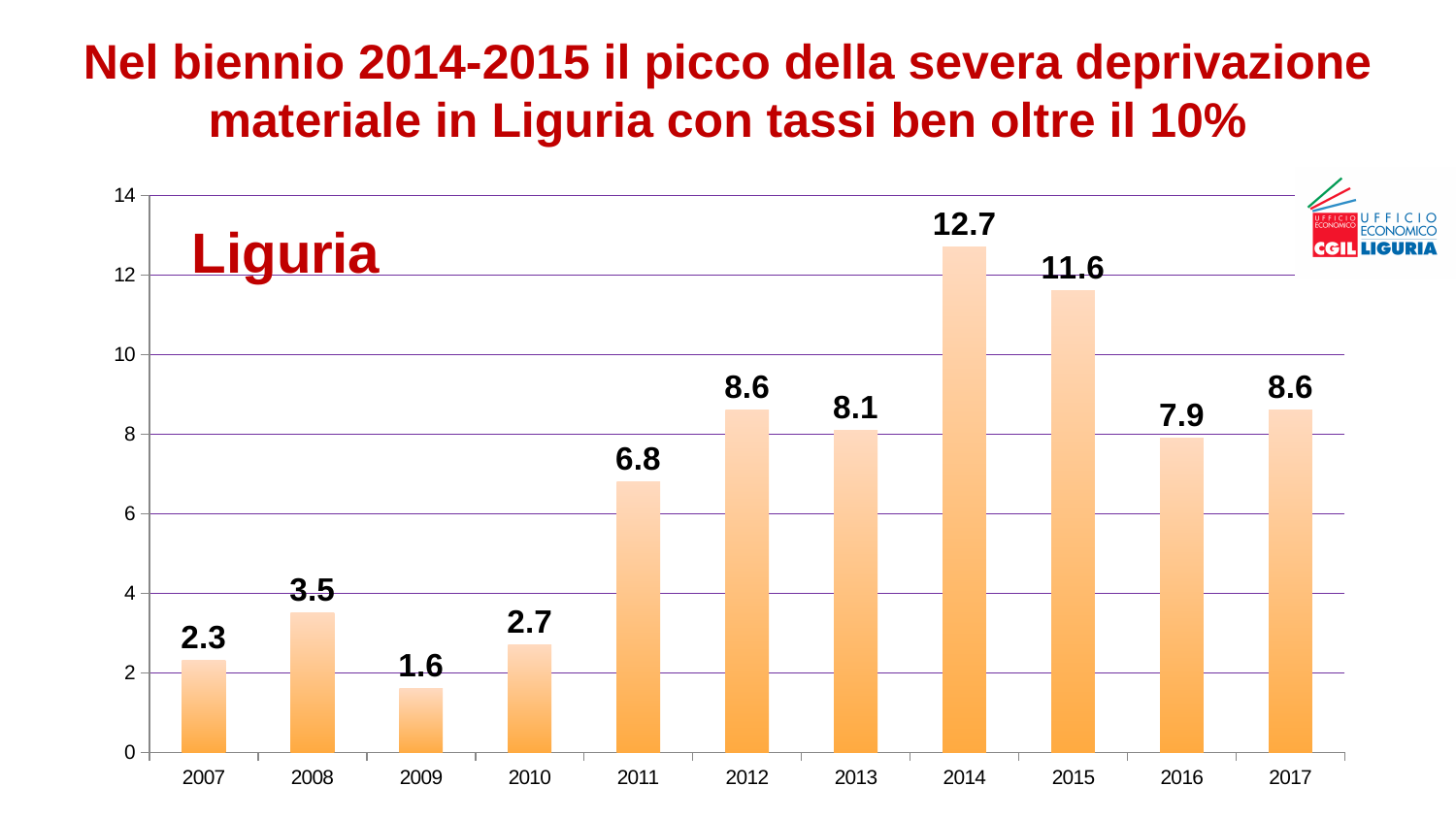
How many years are shown on the x axis? 11 What is the difference between the values for 2011 and 2010? 4.1 Which year has the lowest value? 2009 What is the value for 2014? 12.7 What is the value for 2016? 7.9 Which is larger, the value for 2012 or the value for 2013? 2012 Is the value for 2015 greater or less than 10? greater What kind of chart is shown on the slide? bar chart What is the difference between the values for 2014 and 2015? 1.1 What label is printed inside the chart area at the top left? Liguria Which year has the highest value? 2014 What is the value for 2009? 1.6